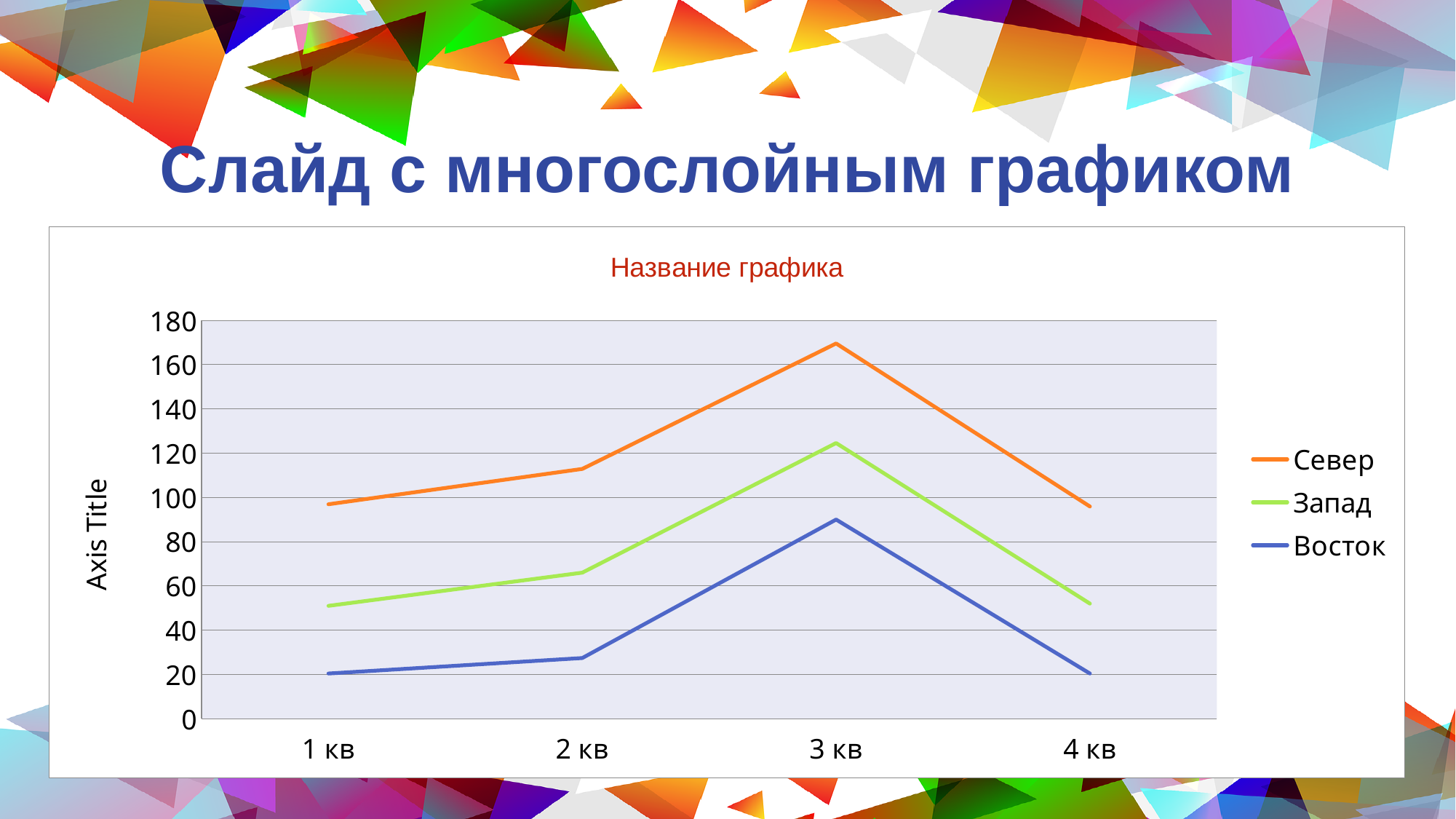
Does the Восток series rise or fall from 1 кв to 3 кв? rise Which series has the highest value at 3 кв? Север How many series does the legend list? 3 Which series has the lowest value at 1 кв? Восток Is the value for Север at 3 кв greater or less than 160? greater Which is larger at 4 кв: the value for Запад or the value for Восток? Запад What is the title of the chart? Название графика In which category does the Север series reach its highest value? 3 кв How many categories are shown on the x axis? 4 What kind of chart is shown on the slide? line chart Is the value for Восток at 1 кв greater or less than 40? less Is the value for Запад at 3 кв greater or less than 120? greater